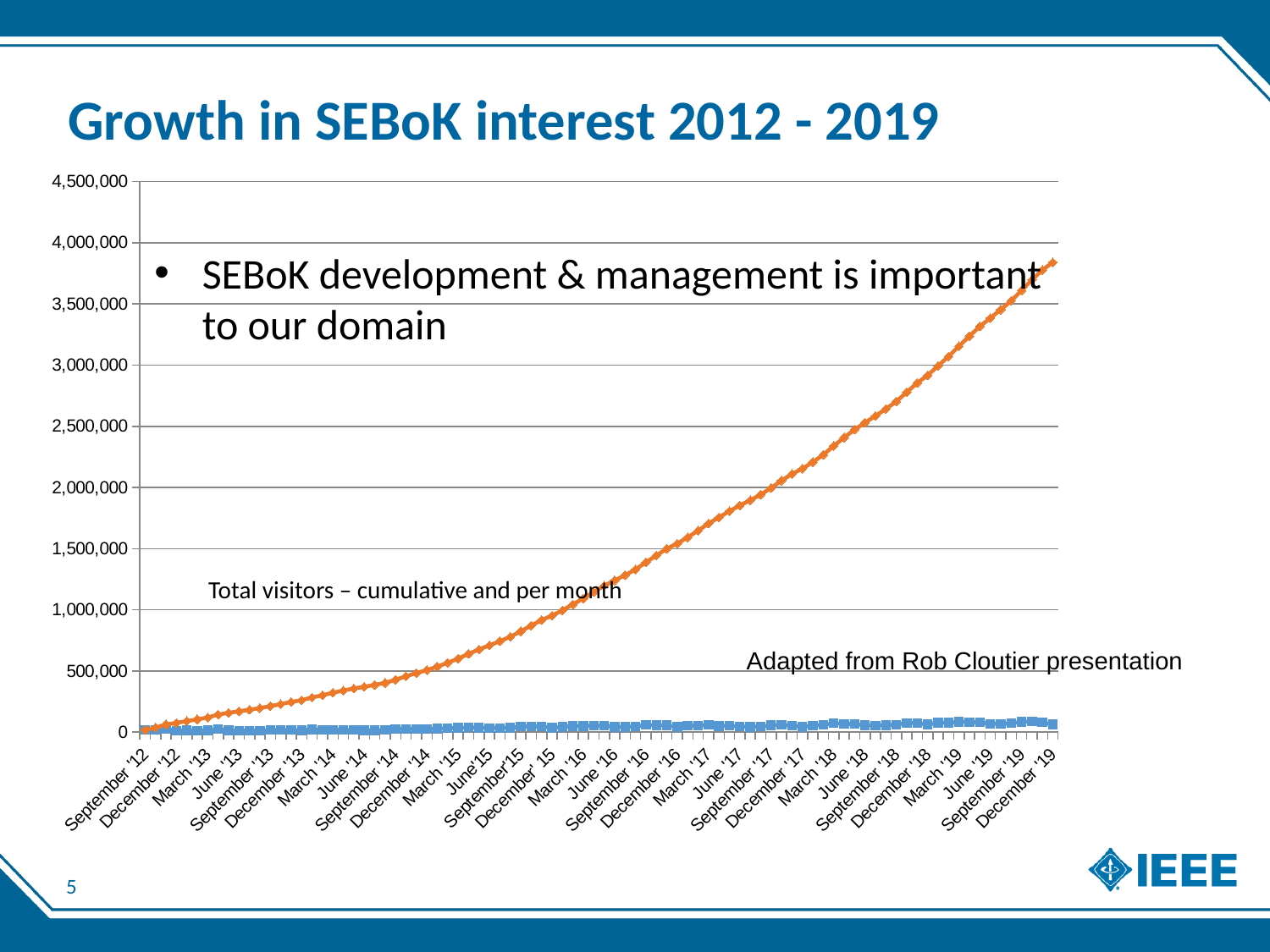
What kind of chart is shown on the slide? Line chart Is the value of the orange cumulative line at June '14 greater or less than 500,000? less Is the value of the orange cumulative line at December '19 greater or less than 3,500,000? greater At which x-axis label does the orange cumulative line reach its highest value? December '19 What is the title of the slide's chart? Growth in SEBoK interest 2012 - 2019 Is the value of the blue per-month line at December '19 greater or less than 500,000? less How many lines (series) are plotted on the chart? 2 What is the highest value shown on the chart's y axis? 4,500,000 Does the orange cumulative visitors line rise or fall from September '12 to December '19? Rises At which x-axis label does the orange cumulative line have its lowest value? September '12 At December '19, which line has the larger value, the orange cumulative line or the blue per-month line? Orange cumulative line